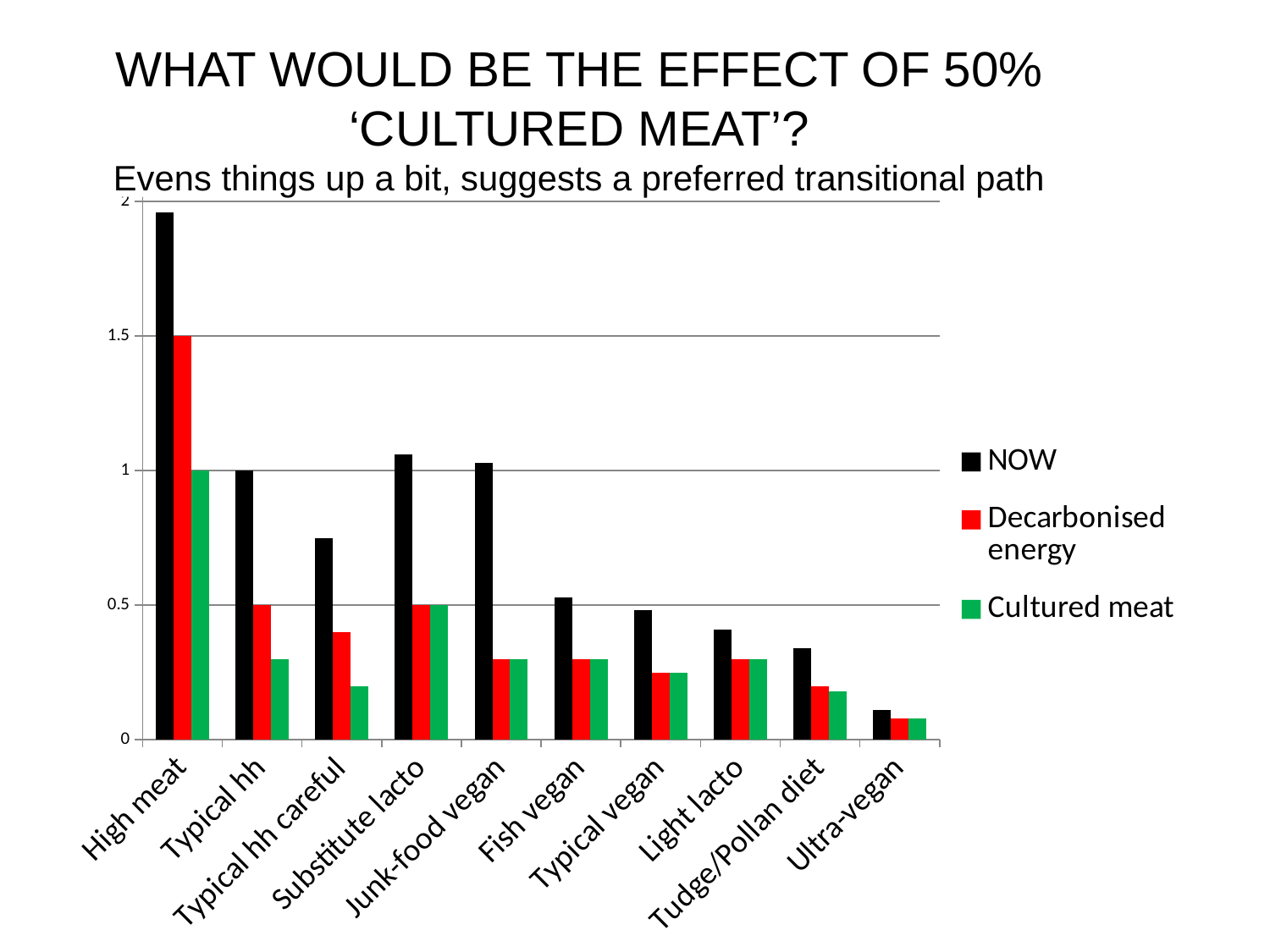
Is the NOW value for High meat greater or less than 1.5? greater Which has the larger NOW value, Substitute lacto or Typical hh careful? Substitute lacto How many diet categories are shown on the x axis? 10 What is the Decarbonised energy value for High meat? 1.5 Which series is shown in green in the legend? Cultured meat Is the NOW value for Light lacto greater or less than 0.5? less What is the NOW value for Typical hh? 1 What kind of chart is shown on the slide? bar chart Which category has the lowest NOW value? Ultra-vegan Which category has the highest NOW value? High meat What is the Cultured meat value for High meat? 1 How many series does the legend list? 3